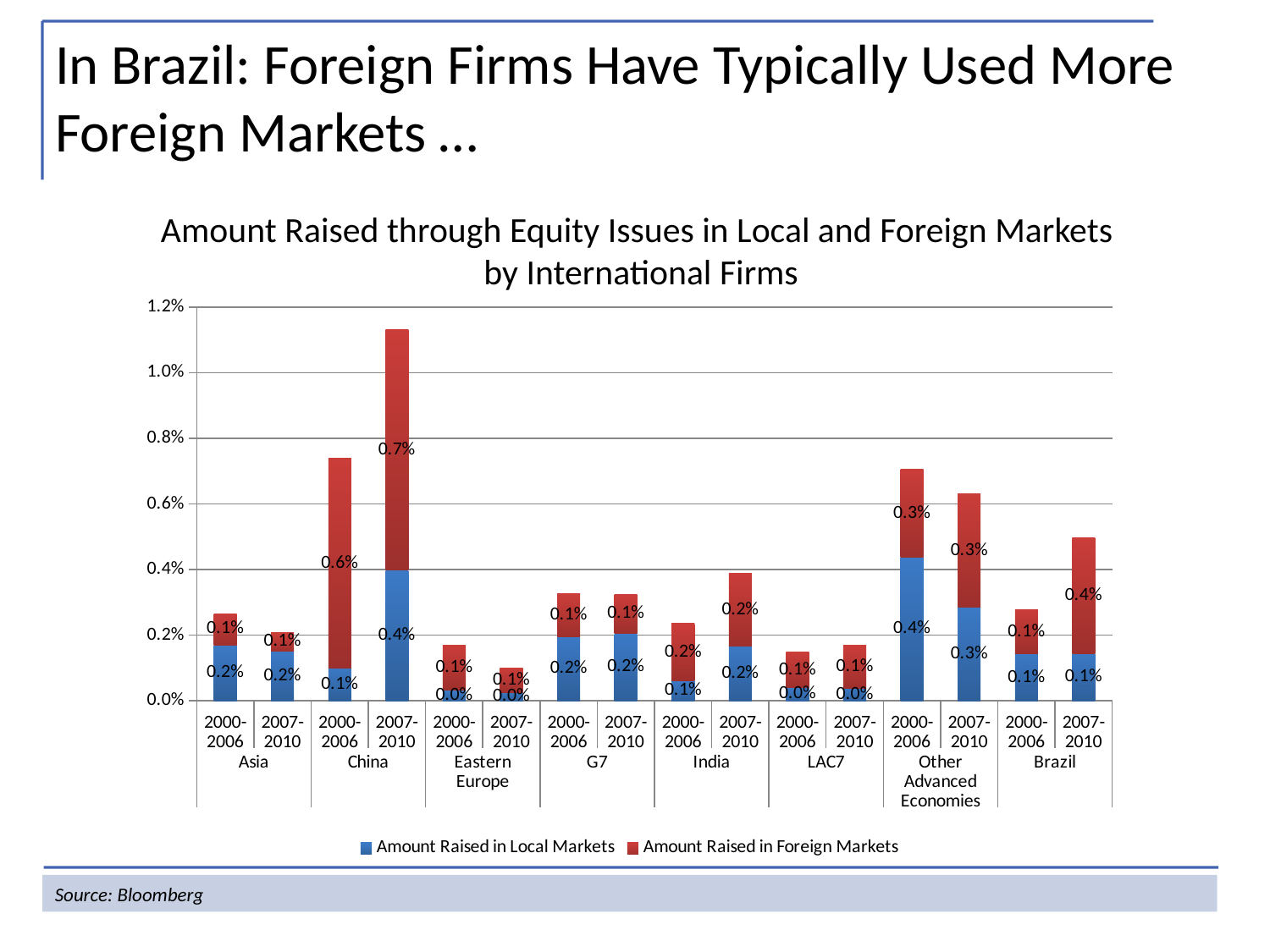
What is the Amount Raised in Foreign Markets for China in 2007-2010? 0.7% What is the difference between the Amount Raised in Foreign Markets and the Amount Raised in Local Markets for China in 2007-2010? 0.3% Is the total stacked bar for China in 2007-2010 greater or less than 1.0%? greater What is the Amount Raised in Foreign Markets for Brazil in 2007-2010? 0.4% How many region groups are shown on the x axis? 8 What is the Amount Raised in Local Markets for Other Advanced Economies in 2000-2006? 0.4% For Brazil in 2007-2010, which is larger: the Amount Raised in Local Markets or the Amount Raised in Foreign Markets? Amount Raised in Foreign Markets How many series does the legend list? 2 Which region and period has the tallest stacked bar? China, 2007-2010 What is the Amount Raised in Local Markets for Brazil in 2007-2010? 0.1% Did the Amount Raised in Foreign Markets for Brazil rise or fall from 2000-2006 to 2007-2010? Rise What kind of chart is shown on the slide? Stacked bar chart